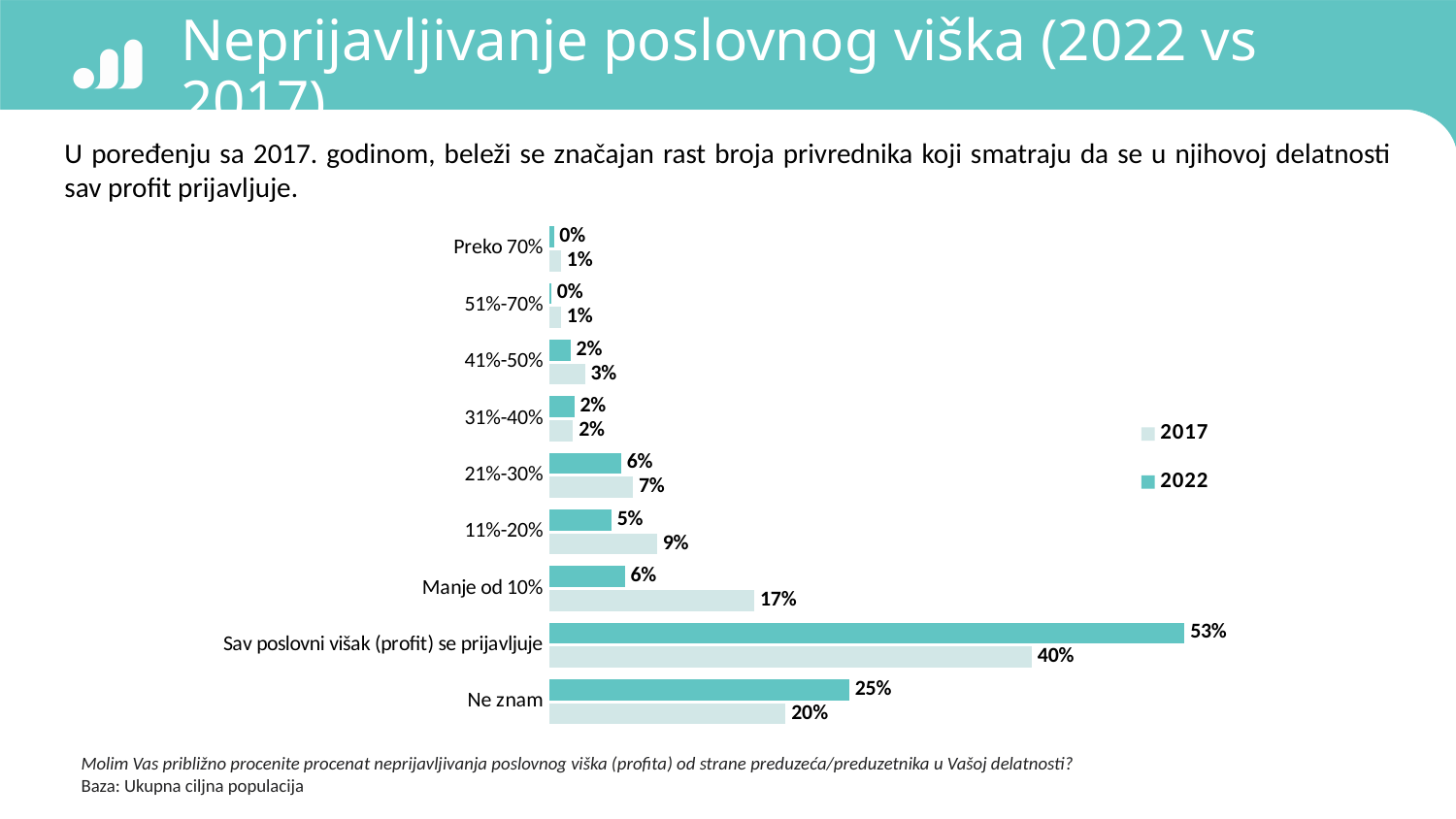
What is the difference between the 2017 and 2022 values for "Manje od 10%"? 11% What is the 2017 value for "Manje od 10%"? 17% Which category has the highest 2022 value? Sav poslovni višak (profit) se prijavljuje What is the 2017 value for "Ne znam"? 20% For "Ne znam", which year has the larger value, 2017 or 2022? 2022 What kind of chart is shown on the slide? Bar chart Which category has the highest 2017 value? Sav poslovni višak (profit) se prijavljuje What is the 2022 value for "Sav poslovni višak (profit) se prijavljuje"? 53% What is the difference between the 2022 and 2017 values for "Sav poslovni višak (profit) se prijavljuje"? 13% What is the 2022 value for "11%-20%"? 5% How many categories are shown on the chart? 9 How many series does the legend list? 2